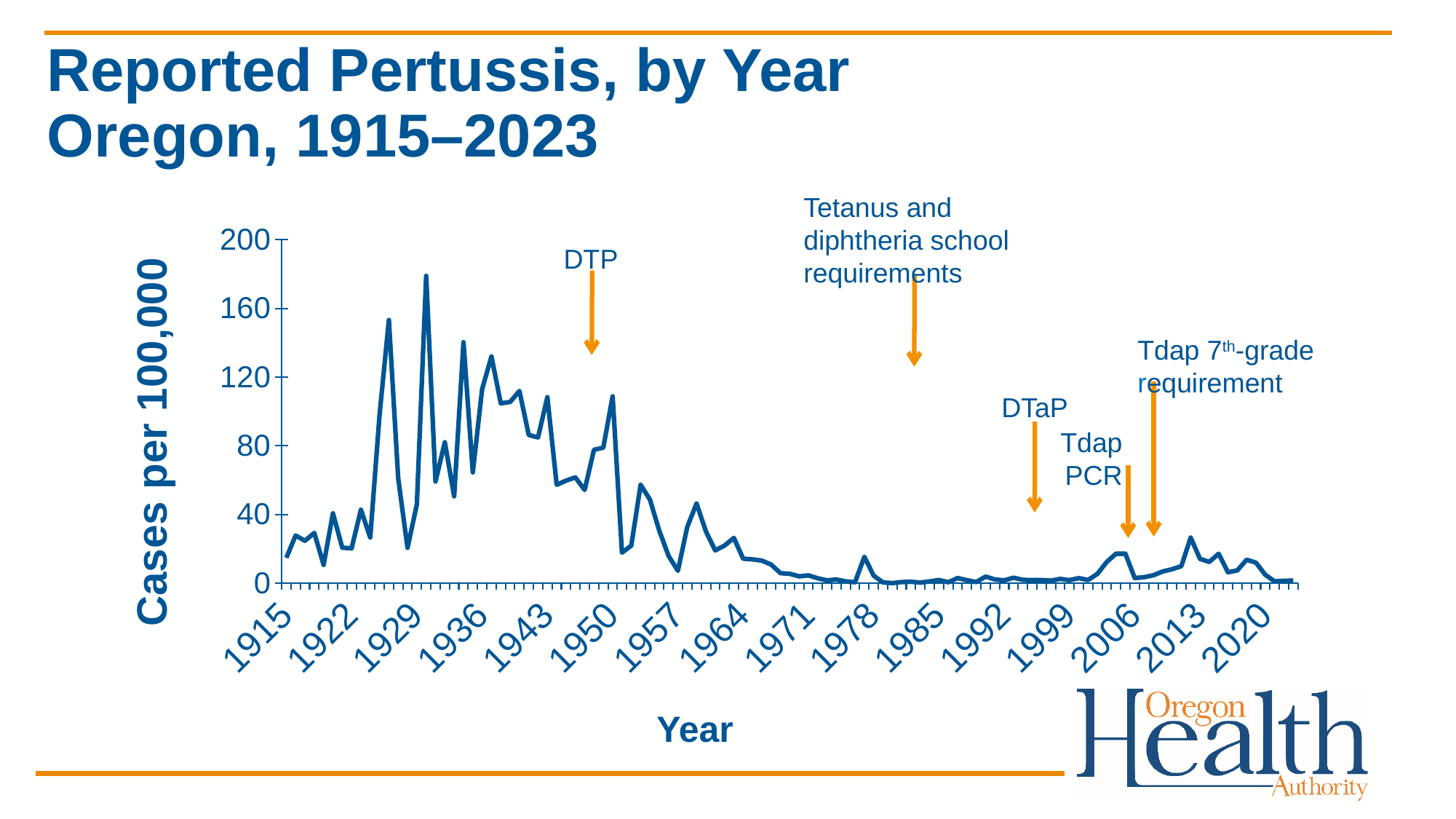
What is the label on the vertical axis? Cases per 100,000 Which year has the larger value, 1936 or 1985? 1936 Is the value for 1915 greater or less than 40? less Is the value for 2013 greater or less than 40? less Overall, do the reported pertussis values rise or fall from 1915 to 2023? Fall Is the highest value on the chart greater or less than 160? greater How many data series are plotted on the chart? 1 Which year has the larger value, 1915 or 1950? 1950 How many annotated events (with arrows) are marked on the chart? 5 What kind of chart is shown on the slide? Line chart